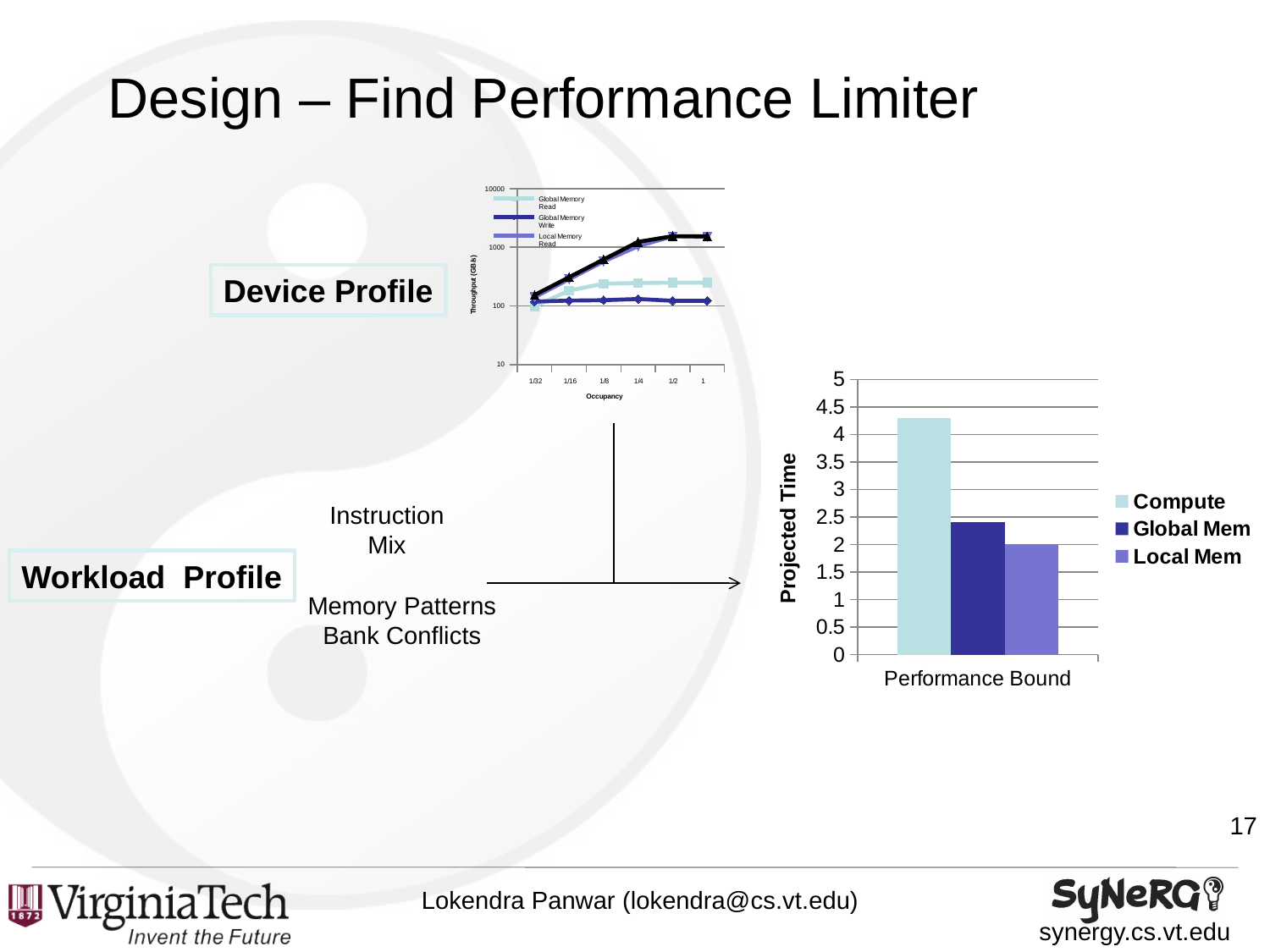
On the Device Profile line chart, how many occupancy values are shown on the x axis? 6 On the bar chart on the right, is the projected time for Local Mem greater or less than 1.5? greater On the bar chart on the right, is the projected time for Global Mem greater or less than 3? less On the bar chart on the right, how many series does the legend list? 3 On the Device Profile line chart, does the Local Memory Read throughput rise or fall as occupancy increases from 1/32 to 1? rise On the bar chart on the right, what kind of chart is it? bar chart On the bar chart on the right, which series has the lowest projected time? Local Mem On the Device Profile line chart, is the Global Memory Write throughput at occupancy 1 greater or less than 1000? less On the bar chart on the right, which series has the highest projected time? Compute On the bar chart on the right, what is the label on the y axis? Projected Time On the bar chart on the right, which is larger, the projected time for Compute or for Global Mem? Compute